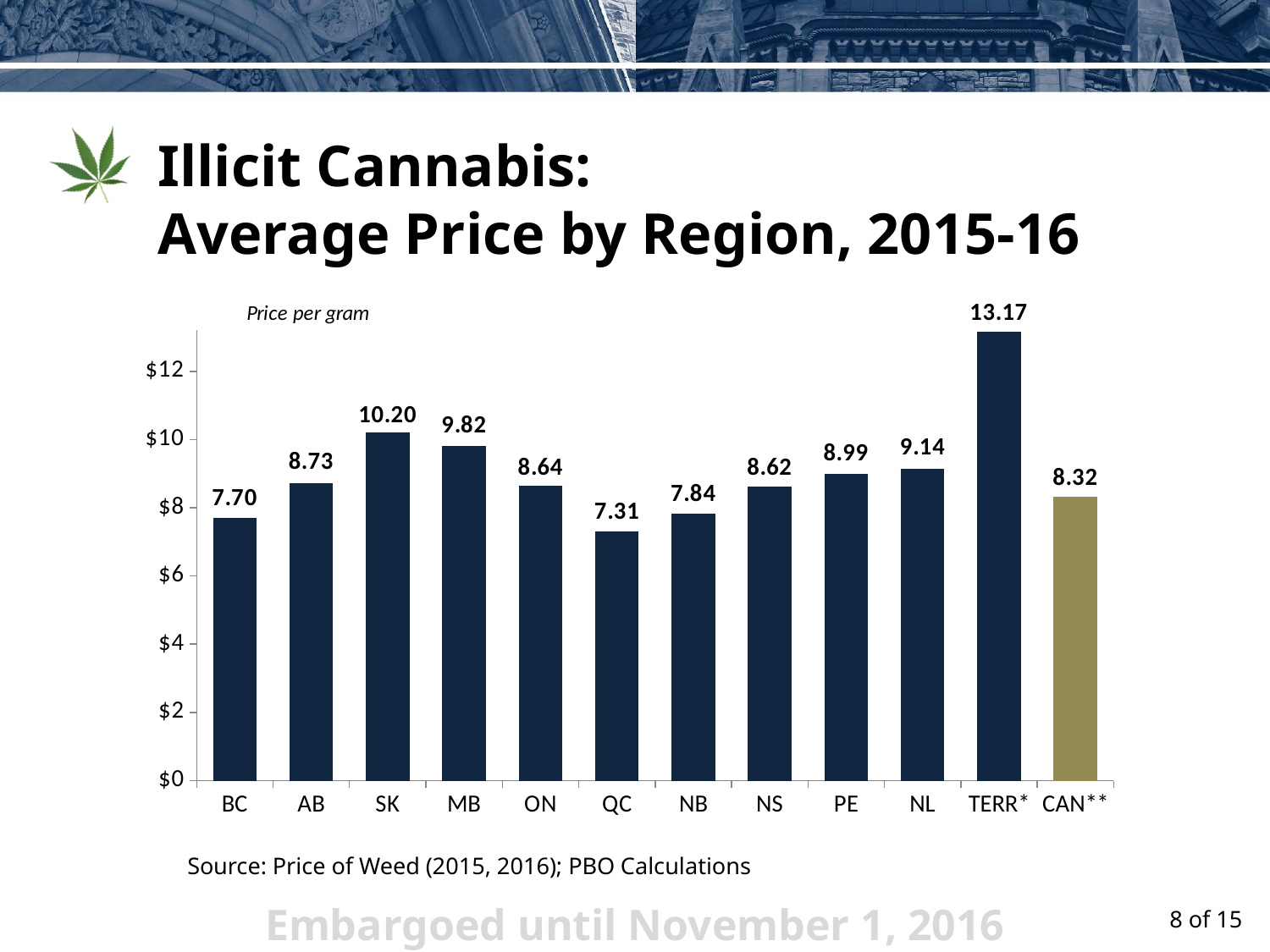
What type of chart is shown on the slide? bar chart What is the average price per gram for SK? 10.20 Which has a higher average price, MB or NL? MB What is the value shown for CAN**? 8.32 Which region has the highest average price per gram? TERR* What is the average price per gram for QC? 7.31 What is the difference between the values for SK and AB? 1.47 Which region has the lowest average price per gram? QC How many bars are shown in the chart? 12 Is the value for TERR* greater or less than $12? greater Which bar is shown in a different colour from the others? CAN** What is the difference between the values for TERR* and BC? 5.47